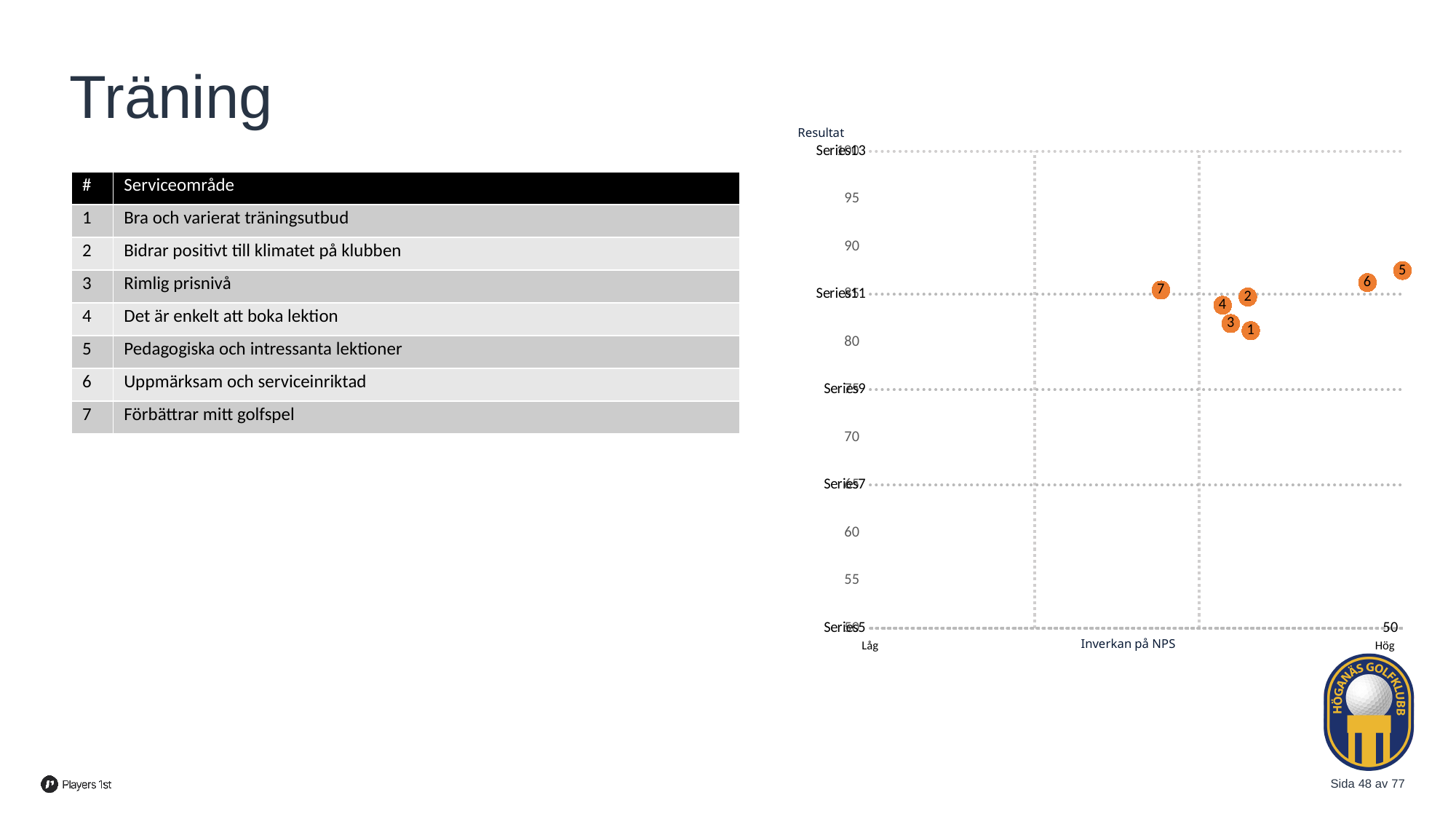
Is the Resultat value for point 7 greater or less than 80? greater What kind of chart is shown on the slide? scatter chart Which point is furthest to the left on the Inverkan på NPS axis? point 7 How many numbered points are plotted in the chart? 7 Is the Resultat value for point 5 greater or less than 85? greater What is the title of the horizontal axis of the chart? Inverkan på NPS Is the Resultat value for point 1 greater or less than 75? greater Which point has the higher Resultat value, point 7 or point 1? point 7 Which point has the higher Resultat value, point 5 or point 3? point 5 What is the title of the vertical axis of the chart? Resultat